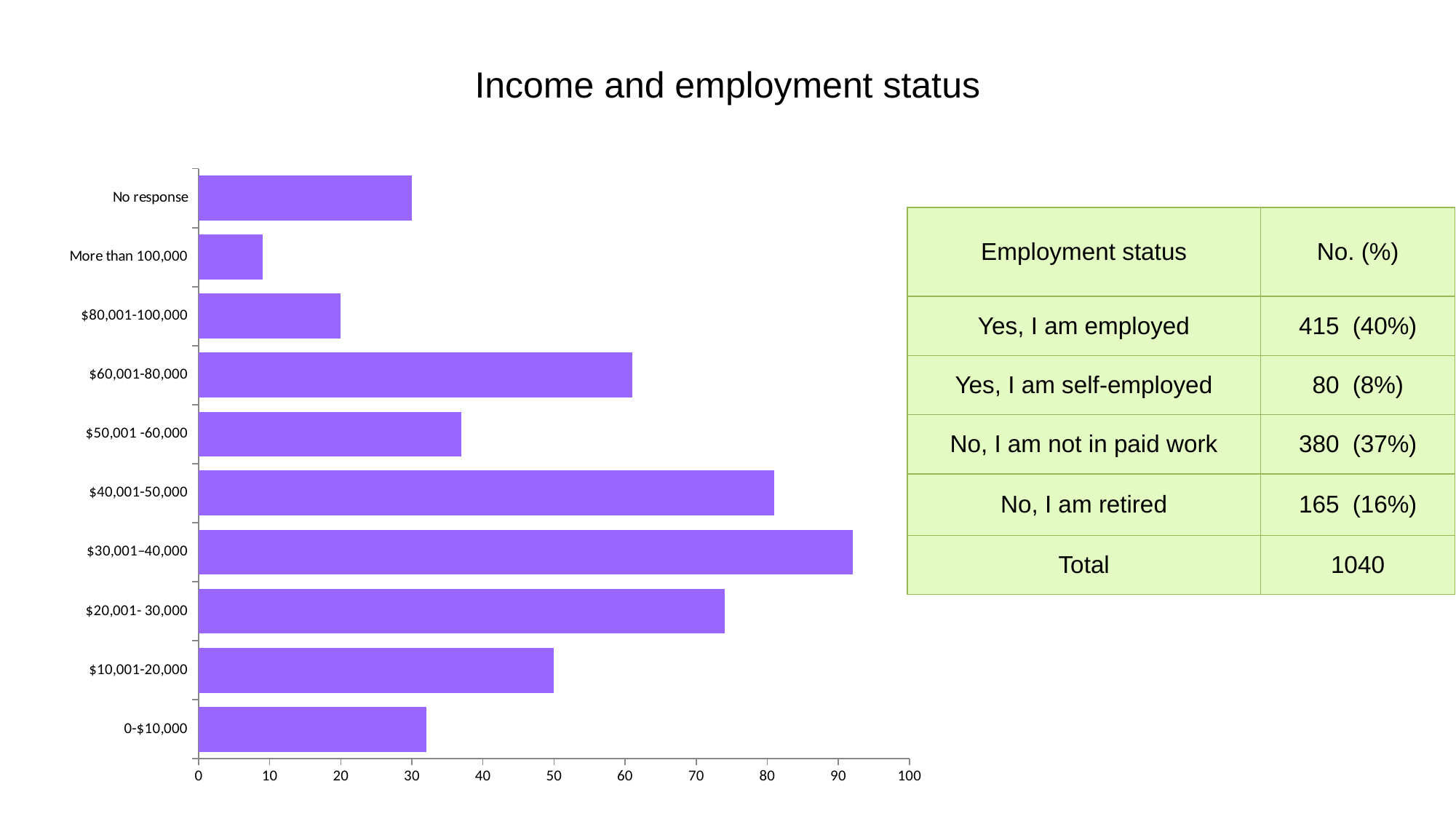
Is the value for $50,001 -60,000 greater or less than 40? less Which income category has the longest bar? $30,001–40,000 Which income category has the shortest bar? More than 100,000 Which has the larger value, $60,001-80,000 or $50,001 -60,000? $60,001-80,000 Which has the larger value, $20,001- 30,000 or $10,001-20,000? $20,001- 30,000 Is the value for $40,001-50,000 greater or less than 70? greater How many income categories are plotted in the bar chart? 10 Is the value for $60,001-80,000 greater or less than 50? greater What is the title of the slide containing the bar chart? Income and employment status What kind of chart is shown on the slide? bar chart